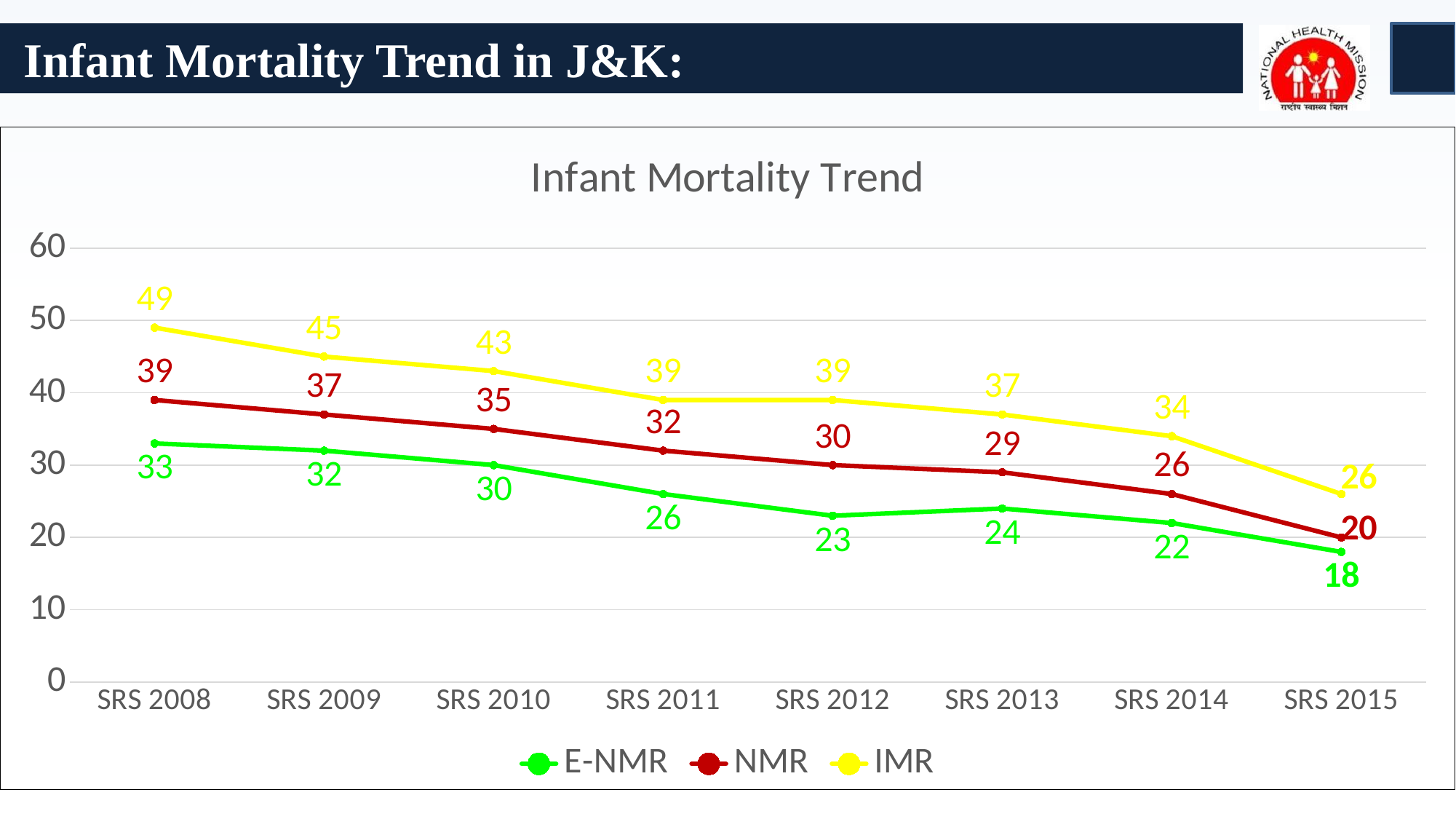
Does the IMR value rise or fall from SRS 2008 to SRS 2015? Fall What is the difference between the IMR and NMR values for SRS 2011? 7 What colour is the IMR line in the chart? Yellow In which year is the IMR value lowest? SRS 2015 In which year is the E-NMR value highest? SRS 2008 What is the NMR value for SRS 2012? 30 Which is larger for SRS 2013: the NMR value or the E-NMR value? NMR What is the E-NMR value for SRS 2015? 18 What kind of chart is shown on the slide? Line chart How many series does the legend list? 3 What is the IMR value for SRS 2008? 49 How many SRS years are shown on the x axis? 8